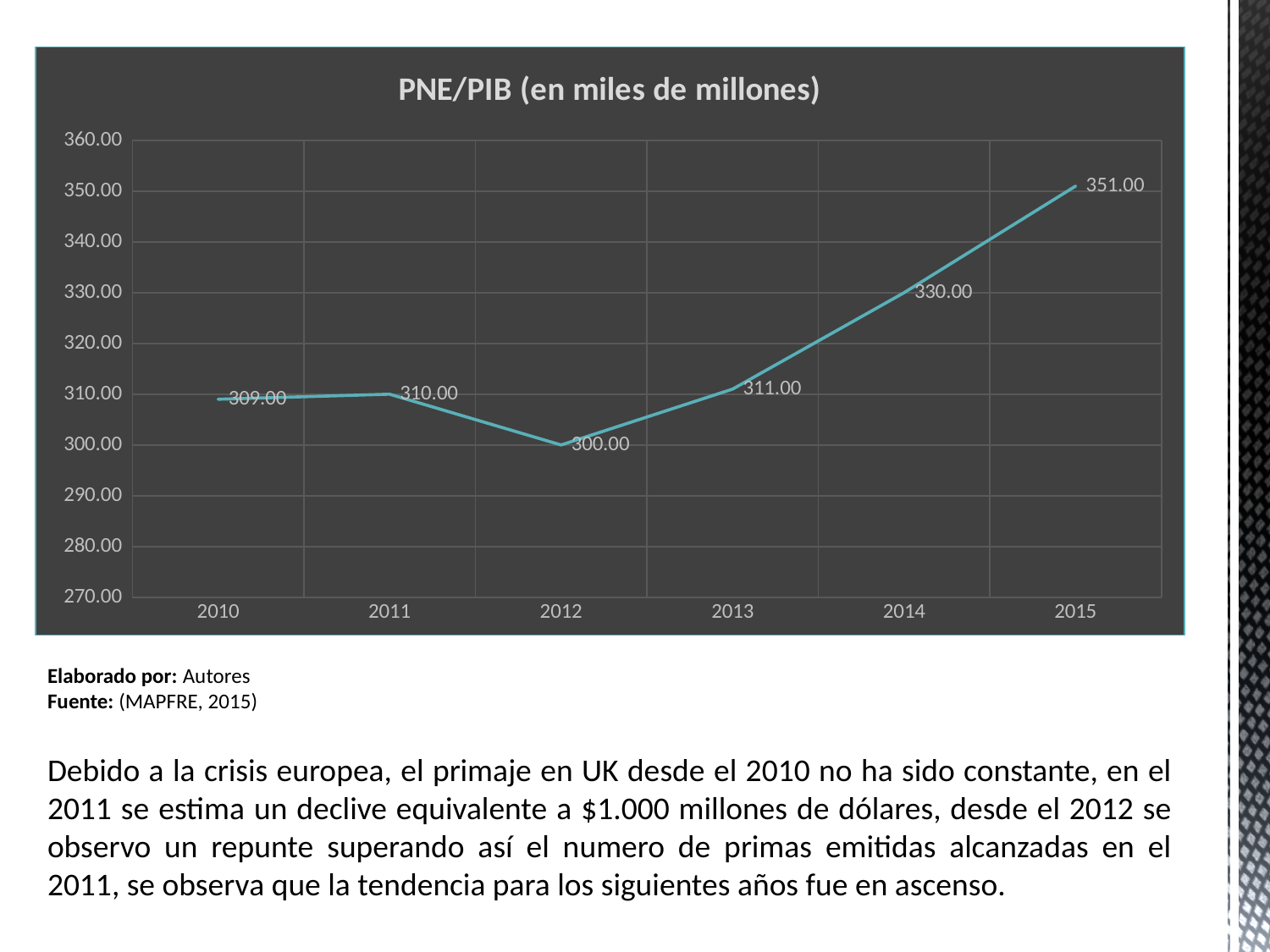
What is the value for 2014? 330.00 Which is larger, the value for 2011 or the value for 2013? 2013 How many years are plotted on the x axis? 6 What is the difference between the values for 2015 and 2014? 21.00 What kind of chart is shown? line chart Which year has the lowest value? 2012 What is the title of the chart? PNE/PIB (en miles de millones) Which year has the highest value? 2015 What is the value for 2010? 309.00 Is the value for 2014 greater or less than 320.00? greater What is the value for 2015? 351.00 What is the value for 2012? 300.00